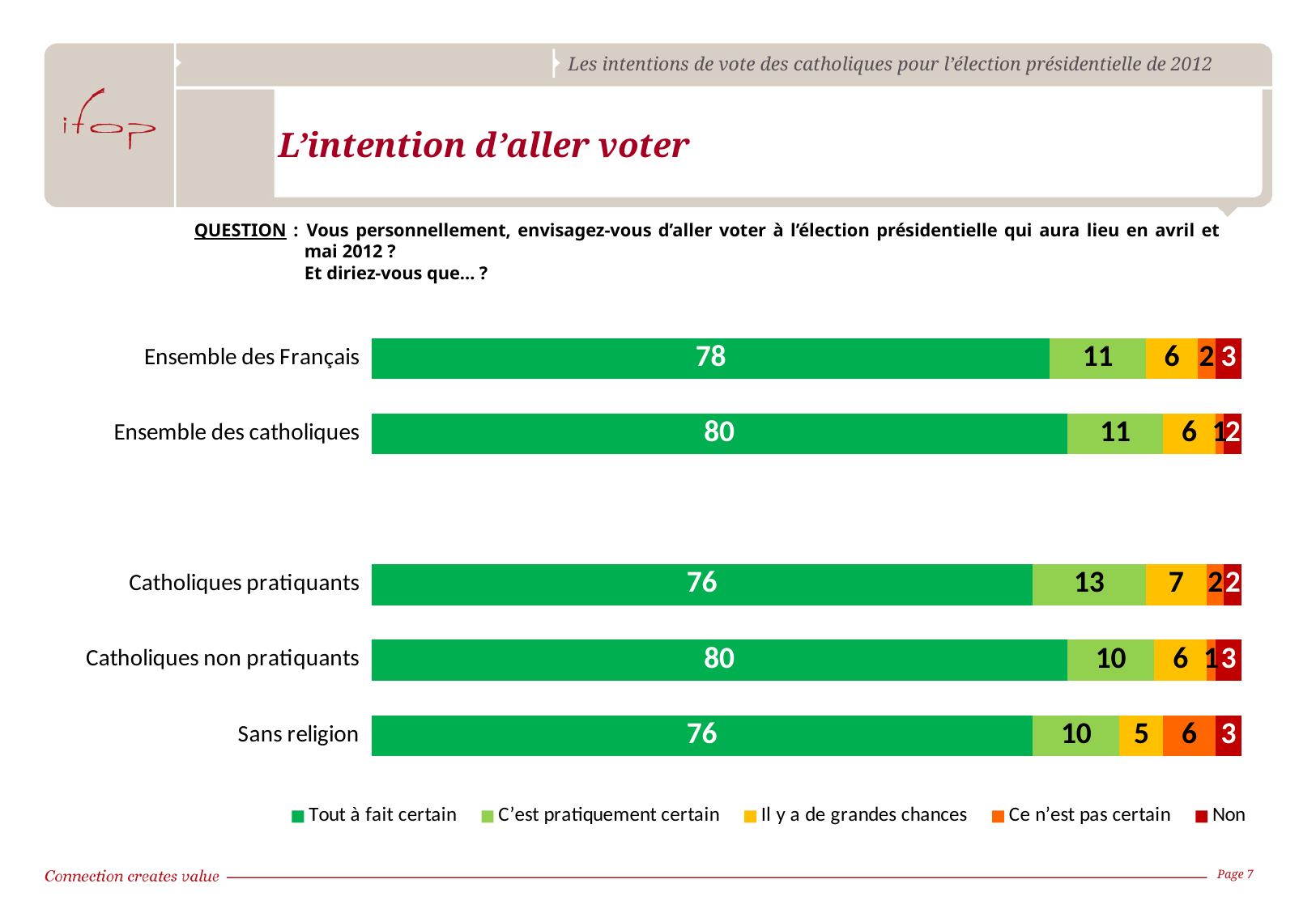
What is the difference between the "Tout à fait certain" values for Ensemble des Français and Sans religion? 2 Which is larger: the "Tout à fait certain" value for Ensemble des catholiques or for Catholiques pratiquants? Ensemble des catholiques How many categories are shown in the chart? 5 Which category has the highest value for "C'est pratiquement certain"? Catholiques pratiquants How many series does the legend list? 5 What is the value for "C'est pratiquement certain" for Catholiques pratiquants? 13 Which category has the lowest value for "Il y a de grandes chances"? Sans religion What kind of chart is shown on the slide? Stacked bar chart What is the value for "Tout à fait certain" for Ensemble des Français? 78 What is the total of the stacked bar for Catholiques pratiquants? 100 What is the value for "Ce n'est pas certain" for Sans religion? 6 What is the value for "Non" for Catholiques non pratiquants? 3